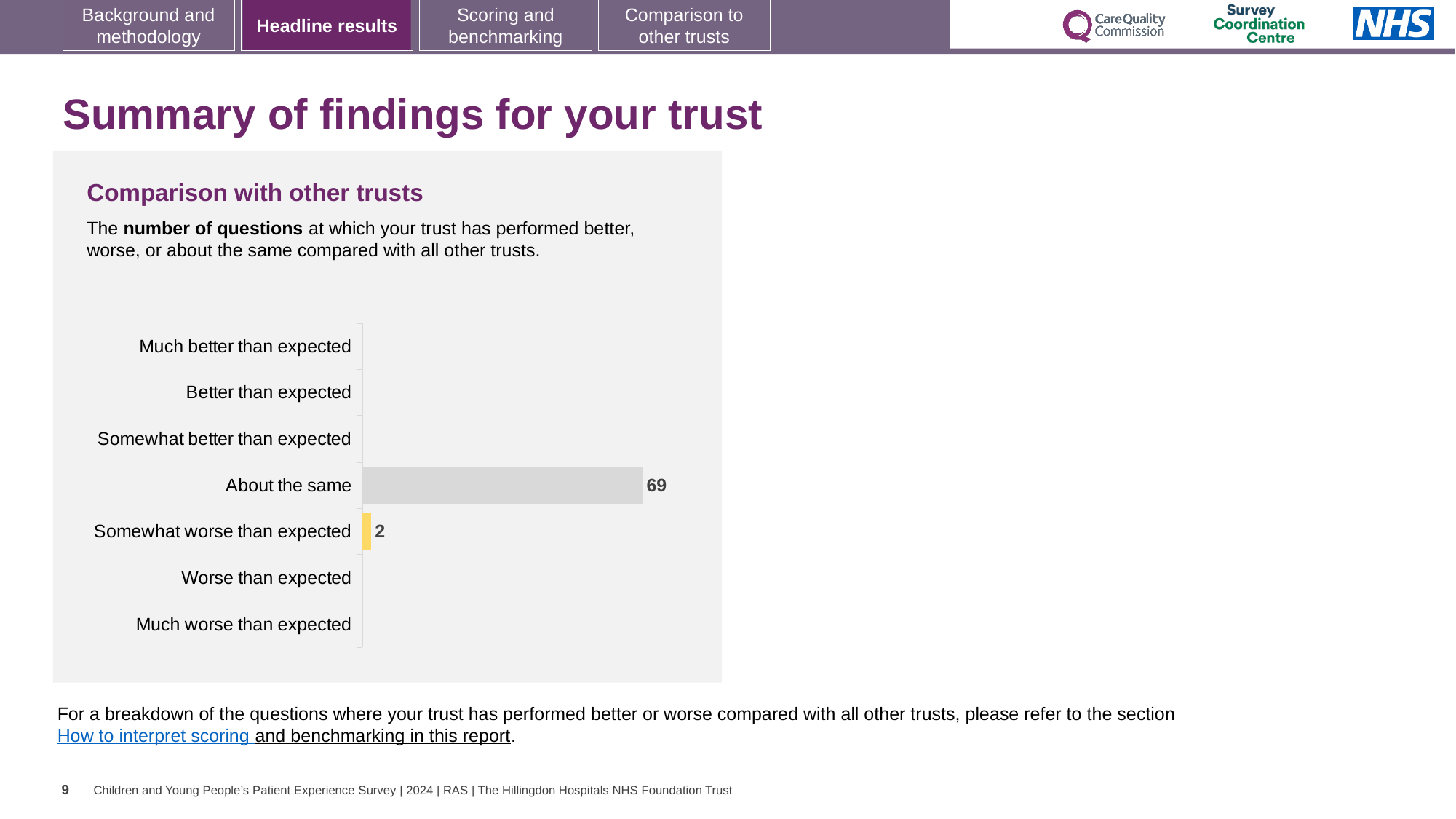
What is the number of questions at which the trust performed 'About the same' compared with other trusts? 69 How many categories in the chart have a visible bar with a data label? 2 What is the number of questions at which the trust performed 'Somewhat worse than expected'? 2 Which is larger: the number of questions 'About the same' or 'Somewhat worse than expected'? About the same What colour is the bar for 'Somewhat worse than expected'? Yellow What is the difference between the number of questions rated 'About the same' and 'Somewhat worse than expected'? 67 What kind of chart is shown on the slide? Bar chart Which category has the highest number of questions in the chart? About the same How many categories are listed on the chart's vertical axis? 7 What is the title of the chart panel on the slide? Comparison with other trusts